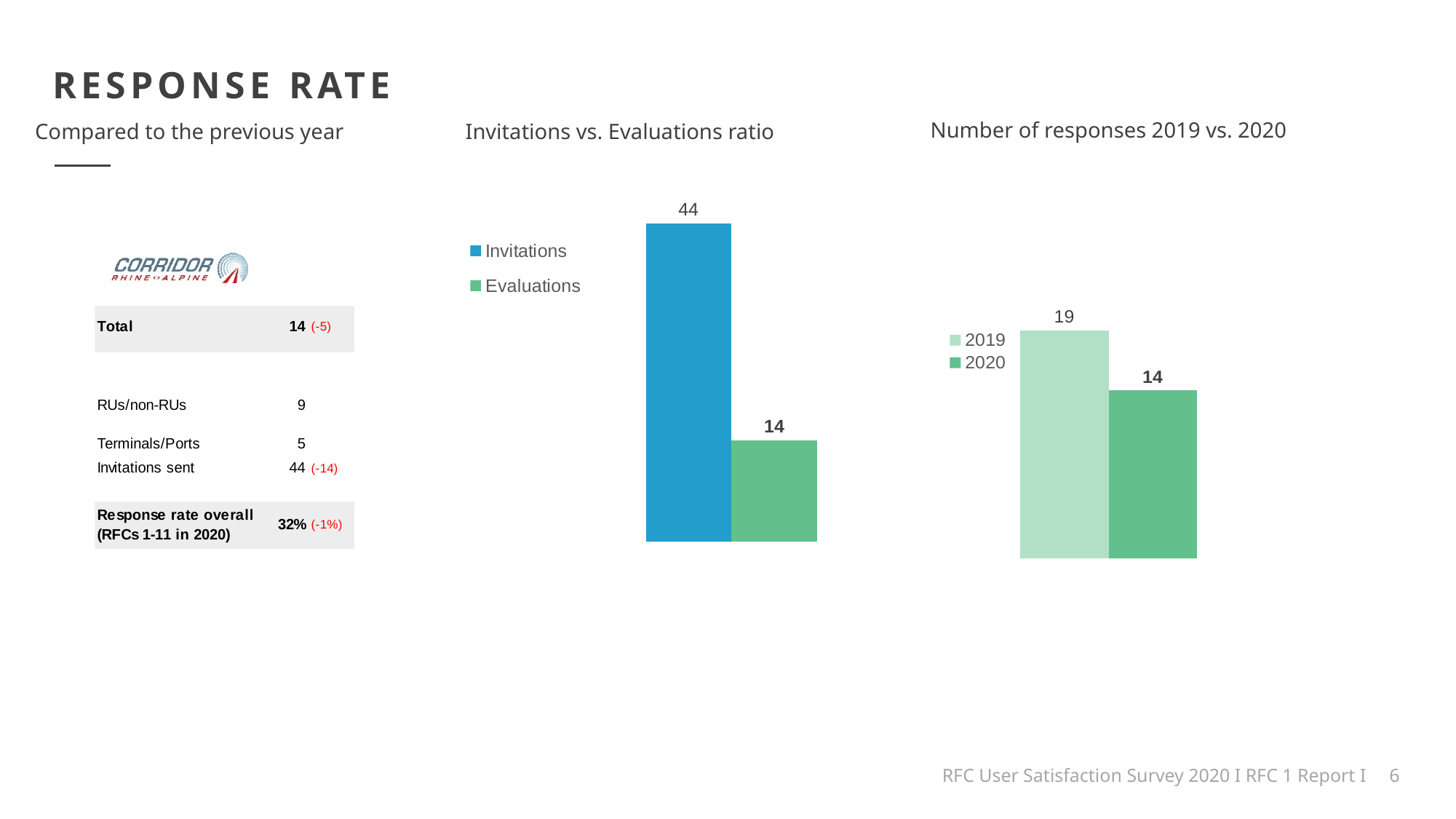
In the 'Number of responses 2019 vs. 2020' chart, how many series does the legend list? 2 In the 'Invitations vs. Evaluations ratio' chart, how many series does the legend list? 2 In the 'Number of responses 2019 vs. 2020' chart, what is the value for 2020? 14 In the 'Invitations vs. Evaluations ratio' chart, what is the value for Evaluations? 14 In the 'Number of responses 2019 vs. 2020' chart, what is the value for 2019? 19 In the 'Invitations vs. Evaluations ratio' chart, which series has the higher value? Invitations In the 'Number of responses 2019 vs. 2020' chart, by how much did the number of responses fall from 2019 to 2020? 5 In the 'Invitations vs. Evaluations ratio' chart, what is the difference between Invitations and Evaluations? 30 In the 'Invitations vs. Evaluations ratio' chart, what colour is the Invitations bar? Blue In the 'Number of responses 2019 vs. 2020' chart, which year has the lower number of responses? 2020 In the 'Invitations vs. Evaluations ratio' chart, what is the value for Invitations? 44 What kind of chart is the 'Invitations vs. Evaluations ratio' chart? Bar chart